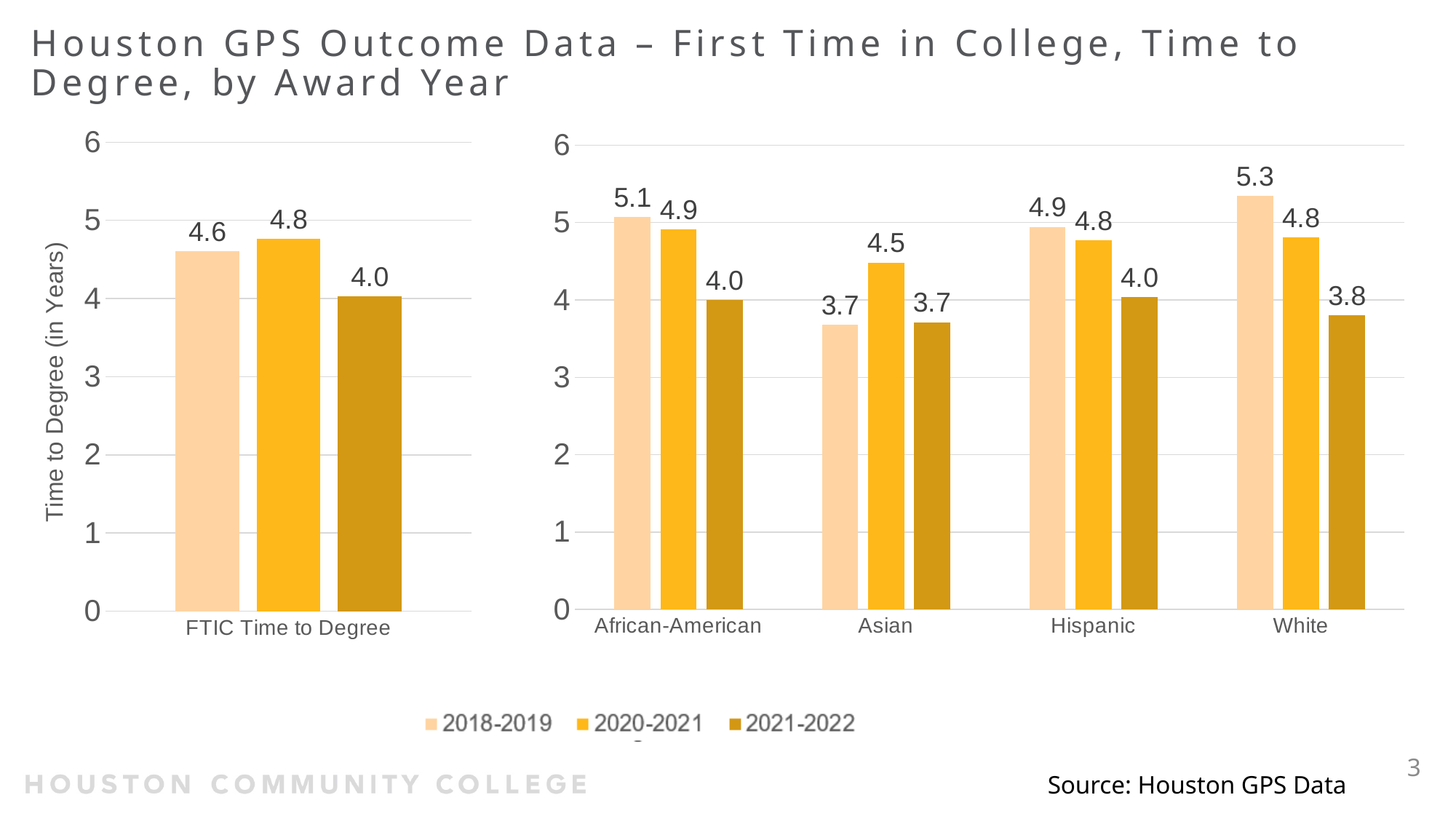
What kind of chart is the right chart? Bar chart In the right chart, how many categories are shown on the x axis? 4 In the left chart, what is the FTIC Time to Degree value for 2018-2019? 4.6 In the right chart, what is the difference between the 2018-2019 and 2021-2022 values for White? 1.5 In the right chart, which is larger for Hispanic: the 2018-2019 value or the 2021-2022 value? 2018-2019 In the left chart, what is the FTIC Time to Degree value for 2021-2022? 4.0 How many series does the legend list? 3 In the right chart, which category has the lowest 2021-2022 value? Asian In the right chart, which category has the highest 2018-2019 value? White What is the y-axis label of the left chart? Time to Degree (in Years) In the right chart, what is the 2020-2021 value for Asian? 4.5 In the right chart, what is the 2018-2019 value for White? 5.3